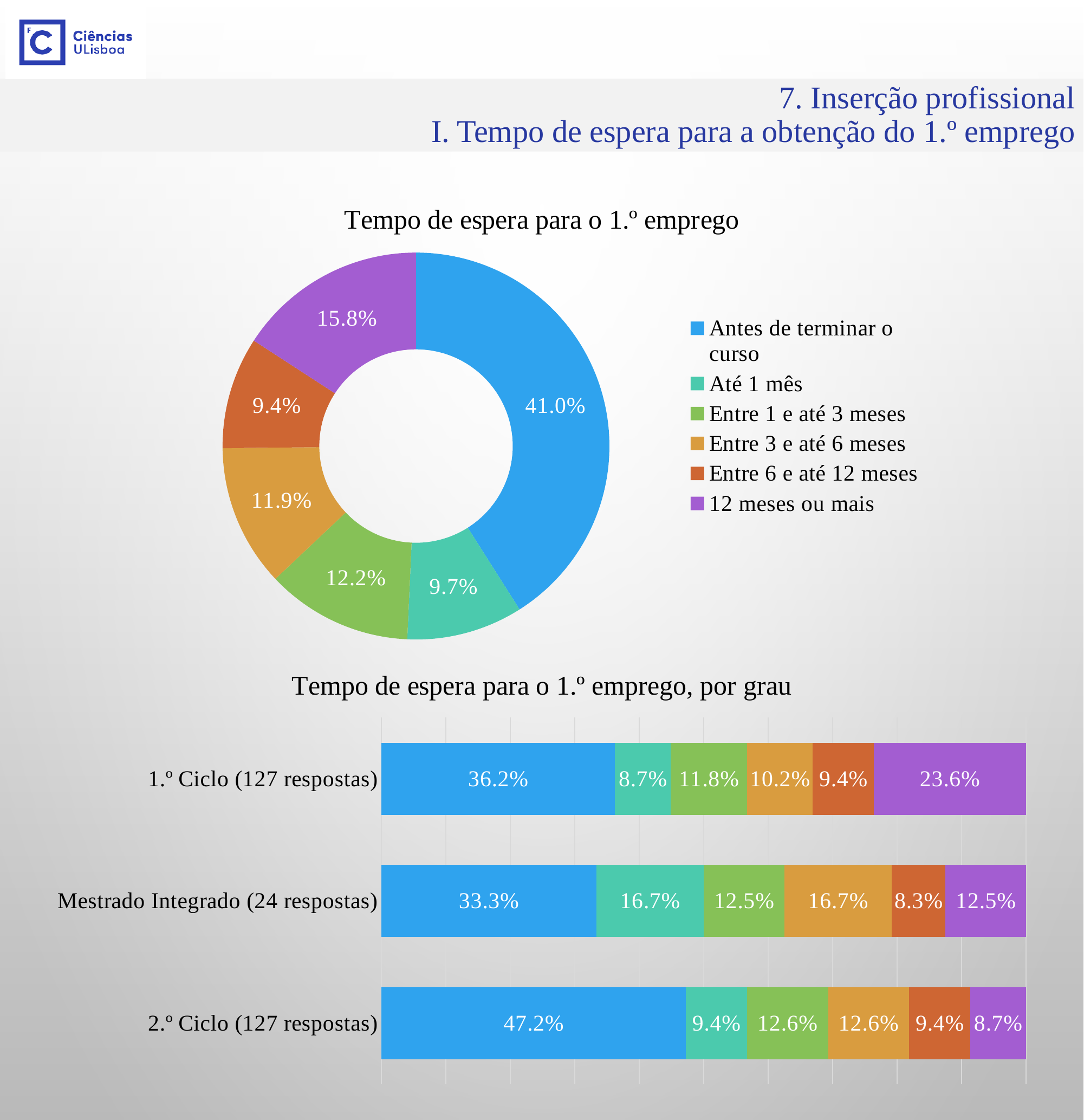
In the chart 'Tempo de espera para o 1.º emprego', what percentage is shown for '12 meses ou mais'? 15.8% What kind of chart is 'Tempo de espera para o 1.º emprego, por grau'? Stacked bar chart In the chart 'Tempo de espera para o 1.º emprego', which category has the largest slice? Antes de terminar o curso In the chart 'Tempo de espera para o 1.º emprego, por grau', which is larger: the blue segment for '1.º Ciclo (127 respostas)' or the blue segment for 'Mestrado Integrado (24 respostas)'? 1.º Ciclo (127 respostas) In the chart 'Tempo de espera para o 1.º emprego', what is the difference between 'Entre 1 e até 3 meses' and 'Até 1 mês'? 2.5 percentage points In the chart 'Tempo de espera para o 1.º emprego, por grau', what is the value of the first (blue) segment for '2.º Ciclo (127 respostas)'? 47.2% What kind of chart is 'Tempo de espera para o 1.º emprego'? Donut (pie) chart In the chart 'Tempo de espera para o 1.º emprego', which category has the smallest slice? Entre 6 e até 12 meses In the chart 'Tempo de espera para o 1.º emprego, por grau', what is the value of the last (purple) segment for '1.º Ciclo (127 respostas)'? 23.6% In the chart 'Tempo de espera para o 1.º emprego', how many categories does the legend list? 6 In the chart 'Tempo de espera para o 1.º emprego, por grau', how many degree categories are shown? 3 In the chart 'Tempo de espera para o 1.º emprego', what percentage is shown for 'Antes de terminar o curso'? 41.0%